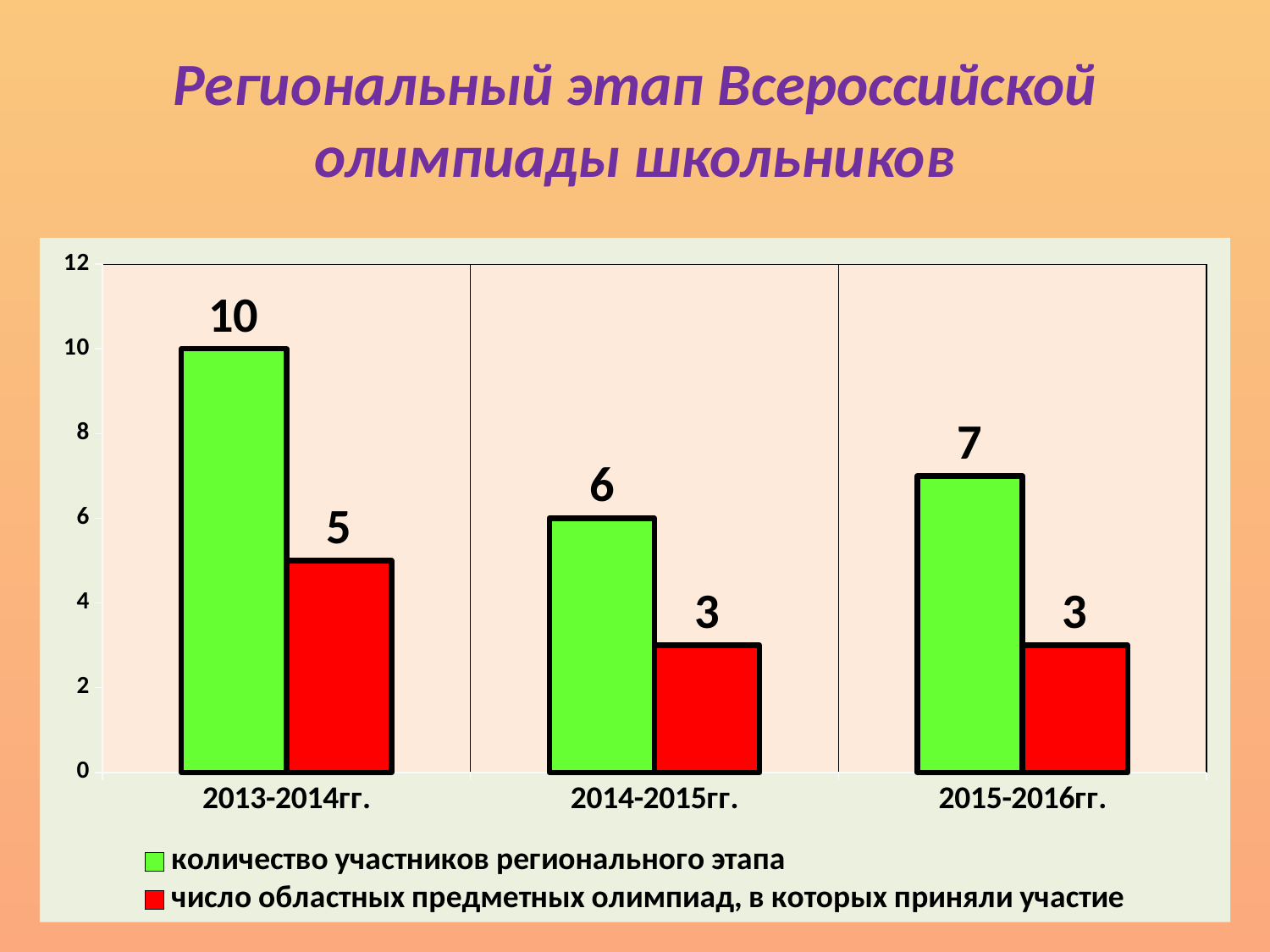
Which is larger: the number of participants of the regional stage in 2014-2015гг. or in 2015-2016гг.? 2015-2016гг. What kind of chart is shown on the slide? bar chart How many series does the legend list? 2 What is the number of participants of the regional stage in 2015-2016гг.? 7 What is the number of participants of the regional stage (количество участников регионального этапа) in 2013-2014гг.? 10 How many year categories are shown on the x axis? 3 What is the number of regional subject olympiads participated in (число областных предметных олимпиад) in 2014-2015гг.? 3 In which year was the number of participants of the regional stage the lowest? 2014-2015гг. Which colour represents the number of participants of the regional stage? green What is the difference between the number of participants of the regional stage in 2013-2014гг. and in 2015-2016гг.? 3 In which year was the number of participants of the regional stage the highest? 2013-2014гг. What is the difference between the number of participants of the regional stage and the number of regional subject olympiads in 2013-2014гг.? 5